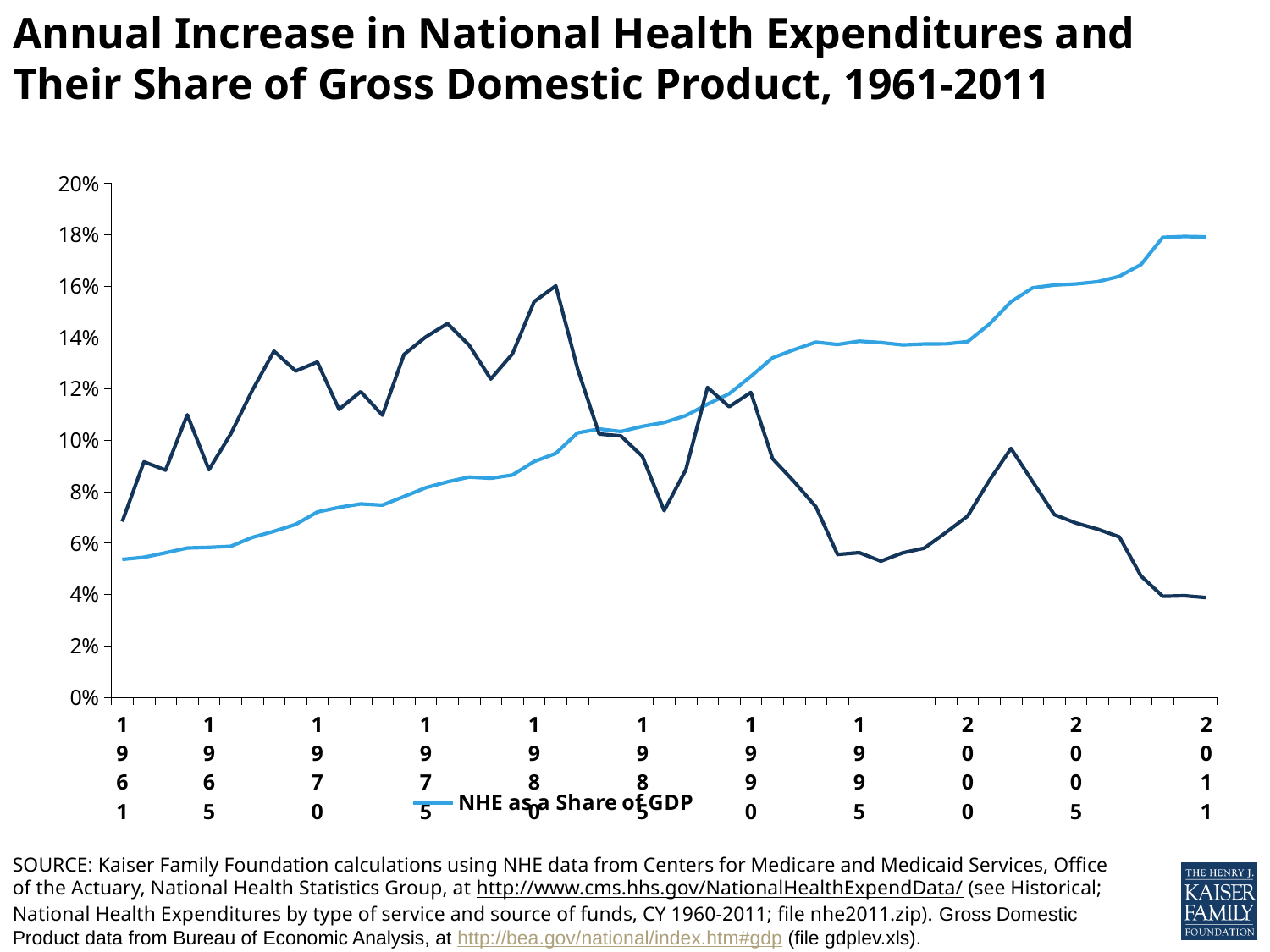
Does the NHE as a Share of GDP line generally rise or fall from 1961 to 2011? rise Is the peak of the dark navy line, reached around 1981, greater or less than 14%? greater How many year labels are shown along the x axis? 11 Is the value of the dark navy line in 2011 greater or less than 6%? less What is the highest value shown on the y axis? 20% Is the value of NHE as a Share of GDP in 1961 greater or less than 6%? less In 2011, which line is higher: the NHE as a Share of GDP line or the dark navy line? NHE as a Share of GDP What kind of chart is shown on the slide? line chart What series name does the chart's legend show? NHE as a Share of GDP